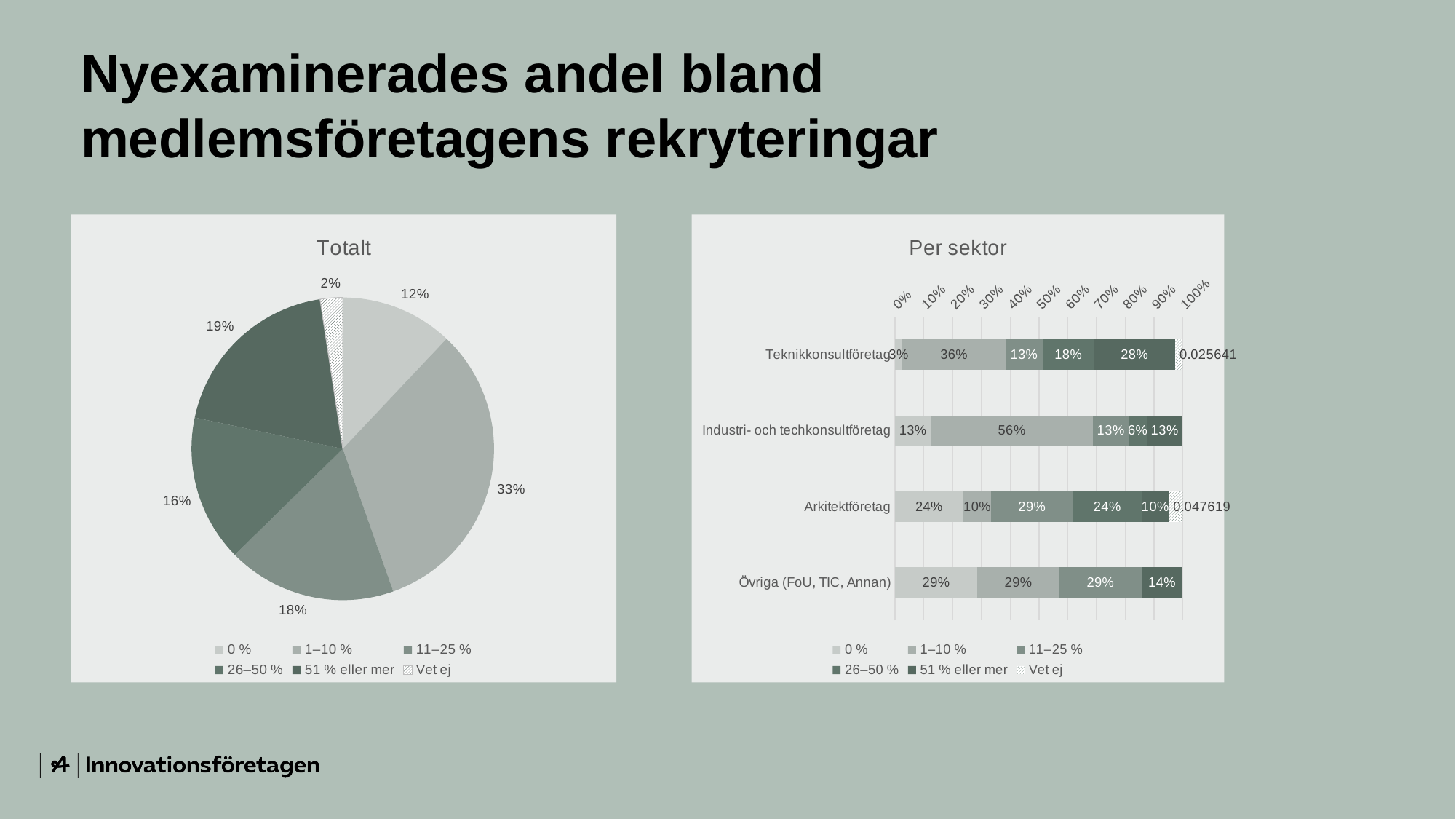
How many sectors are shown in the "Per sektor" chart? 4 In the "Totalt" pie chart, which category has the smallest slice? Vet ej What kind of chart is the "Per sektor" chart? Bar chart How many series does the legend of the "Per sektor" chart list? 6 In the "Totalt" pie chart, which category has the largest slice? 1–10 % In the "Per sektor" chart, which has the larger "0 %" value: Arkitektföretag or Teknikkonsultföretag? Arkitektföretag In the "Per sektor" chart, what is the "1–10 %" value for Industri- och techkonsultföretag? 56% What kind of chart is the "Totalt" chart? Pie chart In the "Totalt" pie chart, what share does the "1–10 %" slice have? 33% In the "Totalt" pie chart, what is the difference between the "1–10 %" slice and the "0 %" slice? 21 percentage points In the "Per sektor" chart, what is the "51 % eller mer" value for Teknikkonsultföretag? 28% In the "Totalt" pie chart, what is the value for "51 % eller mer"? 19%